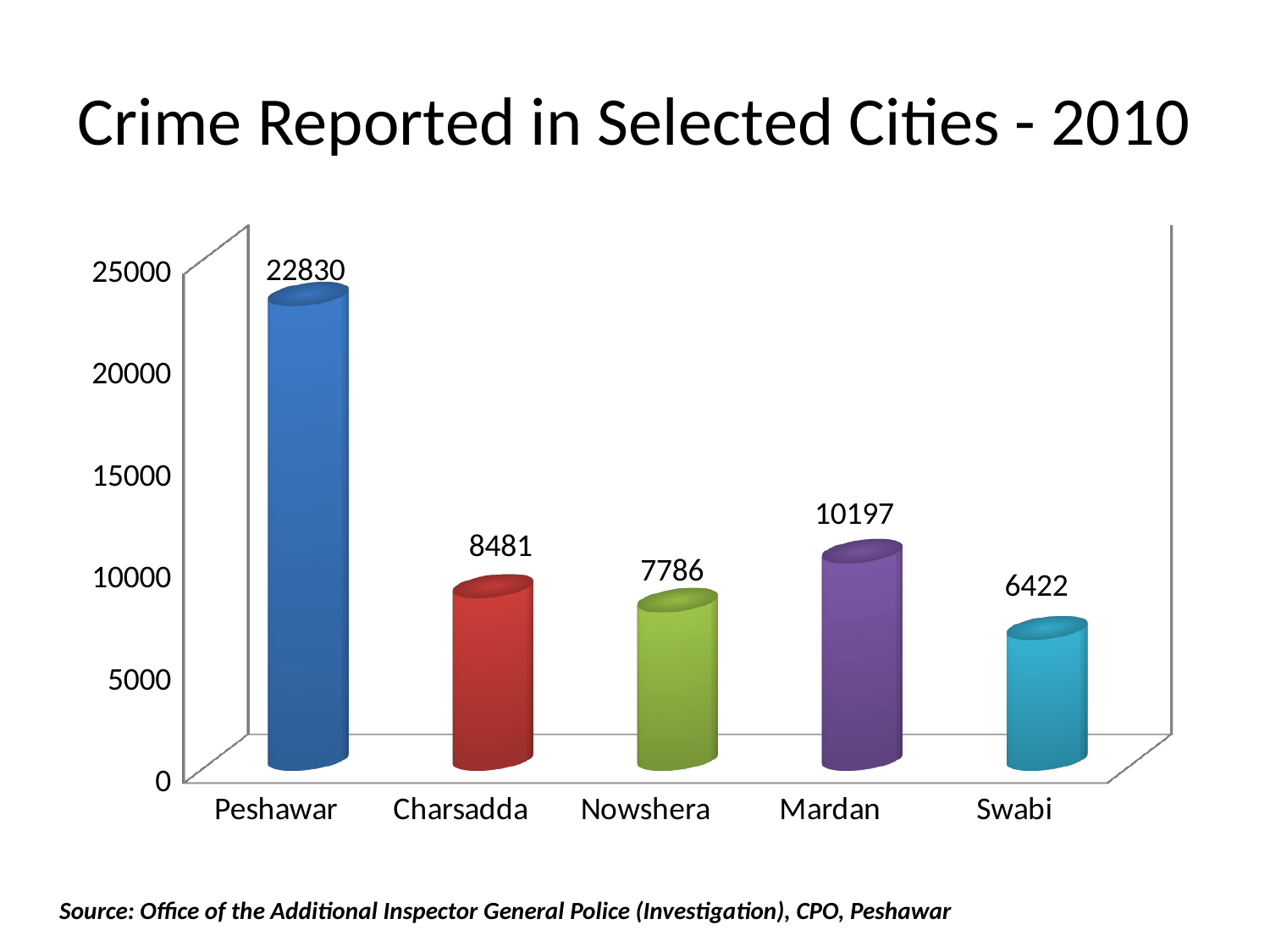
Which city has more crimes reported, Mardan or Charsadda? Mardan What is the title of the chart? Crime Reported in Selected Cities - 2010 What is the difference between the crimes reported in Charsadda and Nowshera? 695 What is the number of crimes reported in Mardan? 10197 How many cities are shown in the chart? 5 What is the number of crimes reported in Swabi? 6422 Which city has the lowest number of crimes reported? Swabi What is the number of crimes reported in Peshawar? 22830 Is the value for Nowshera greater or less than 10000? less What is the difference between the crimes reported in Peshawar and Mardan? 12633 What kind of chart is shown on the slide? Bar chart Which city has the highest number of crimes reported? Peshawar